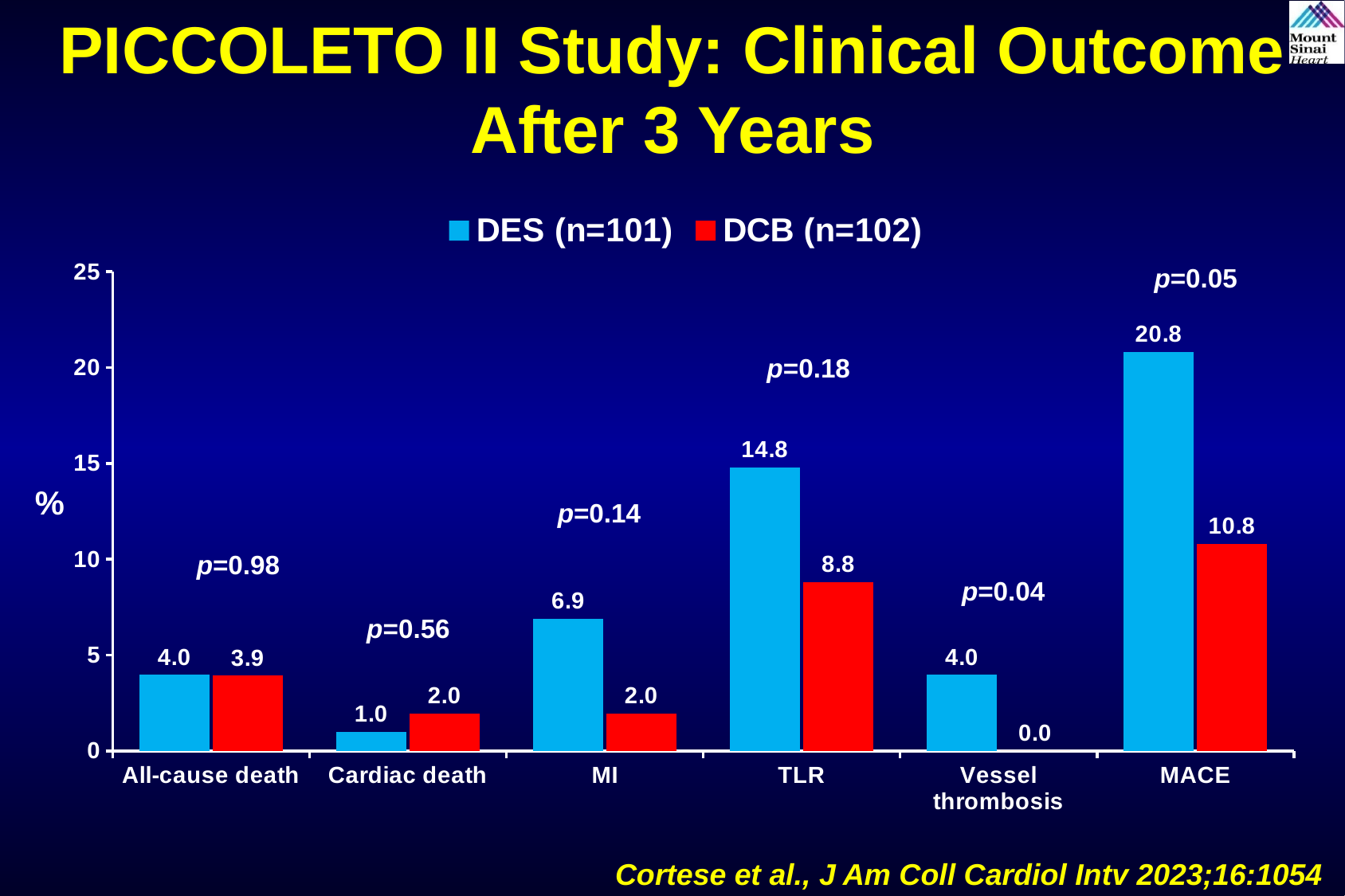
How many outcome categories are shown on the x axis? 6 What is the difference between the DES and DCB values for MACE? 10.0 What p-value is shown above the Vessel thrombosis bars? p=0.04 What is the TLR value for DCB (n=102)? 8.8 For MI, which series has the larger value, DES (n=101) or DCB (n=102)? DES (n=101) What is the difference between the DES and DCB values for TLR? 6.0 What is the MACE value for DES (n=101)? 20.8 What is the Vessel thrombosis value for DCB (n=102)? 0.0 Which category has the highest value for DES (n=101)? MACE How many series does the legend list? 2 Which category has the lowest value for DCB (n=102)? Vessel thrombosis What kind of chart is shown on the slide? Bar chart